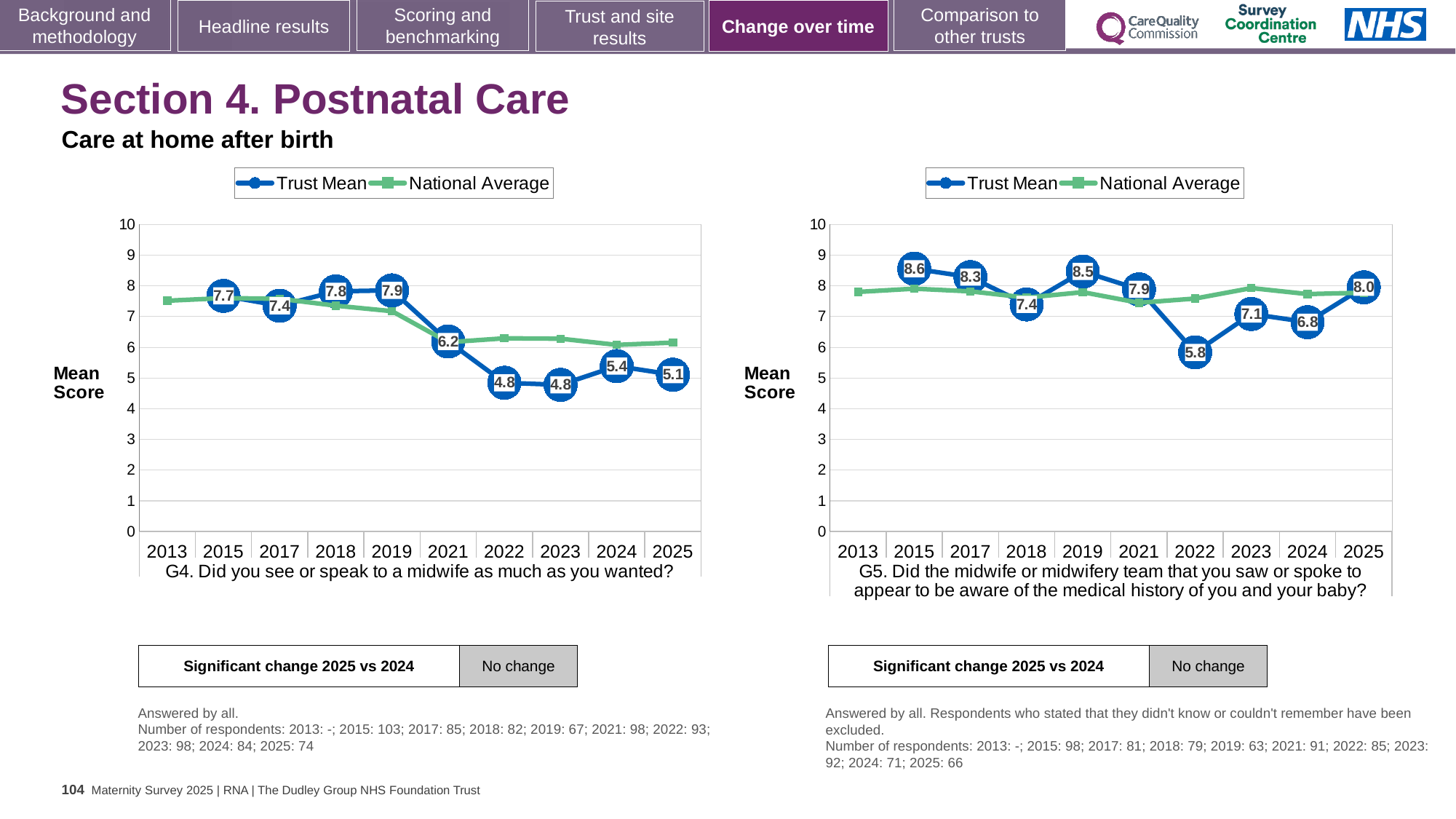
In the G4 chart on the left, does the Trust Mean rise or fall from 2019 to 2022? Fall In the G4 chart on the left, which year has the highest Trust Mean score? 2019 In the G4 chart on the left, is the Trust Mean score for 2021 or 2022 higher? 2021 In the G5 chart on the right, what is the difference between the Trust Mean scores for 2025 and 2024? 1.2 What type of chart is the G4 chart on the left? Line chart In the G5 chart on the right, which year has the lowest Trust Mean score? 2022 What is the significant change result for 2025 vs 2024 shown below the G4 chart on the left? No change In the G5 chart on the right, what is the Trust Mean score for 2022? 5.8 How many series does the legend of the G5 chart on the right list? 2 How many years are shown on the x axis of the G5 chart on the right? 10 In the G4 chart on the left, is the National Average for 2025 greater or less than 5? greater In the G4 chart on the left, what is the Trust Mean score for 2025? 5.1